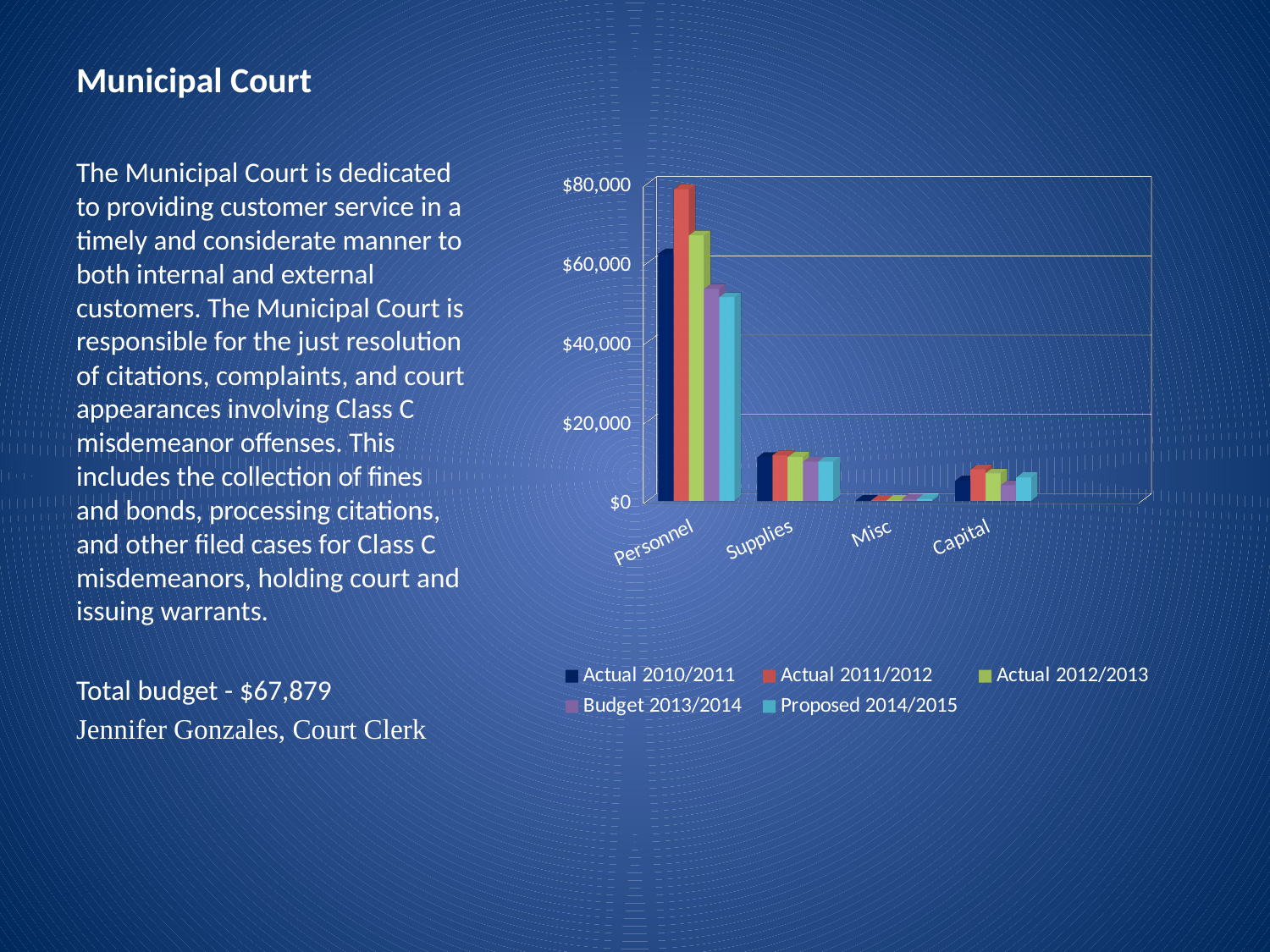
Which series is shown in red in the chart's legend? Actual 2011/2012 For Actual 2010/2011, which category has the larger value: Supplies or Capital? Supplies What is the label of the last series listed in the chart's legend? Proposed 2014/2015 Is the Actual 2010/2011 value for Supplies greater or less than $20,000? less Which category has the highest values in the chart? Personnel How many categories are shown on the x axis of the chart? 4 How many series does the chart's legend list? 5 For Personnel, which is larger: the Actual 2011/2012 value or the Actual 2012/2013 value? Actual 2011/2012 Which category has the lowest values in the chart? Misc Is the Proposed 2014/2015 value for Personnel greater or less than $40,000? greater What kind of chart is shown on the slide? Bar chart Is the Actual 2011/2012 value for Personnel greater or less than $60,000? greater